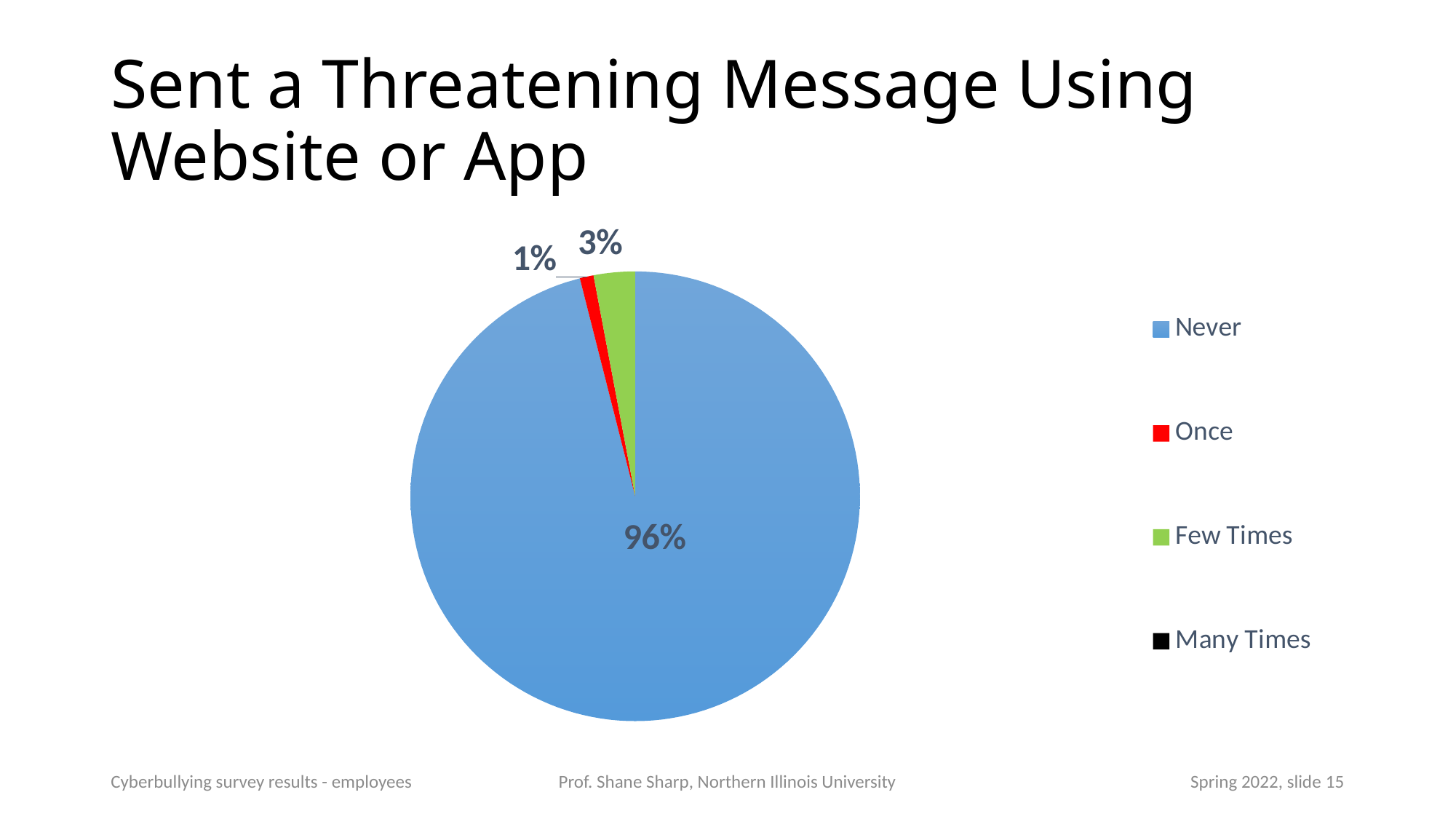
What percentage is shown for the Few Times slice? 3% What is the difference in percentage points between the Never slice and the Few Times slice? 93 How many entries does the legend list? 4 What colour is the Never slice in the pie chart? blue What share of the pie is labelled for the Never slice? 96% What is the title of the slide containing the pie chart? Sent a Threatening Message Using Website or App What kind of chart is shown on the slide? pie chart What percentage is shown for the Once slice? 1% What is the difference in percentage points between the Few Times slice and the Once slice? 2 Which is larger, the Few Times slice or the Once slice? Few Times Is the value for Never greater or less than 50%? greater Which category has the largest slice of the pie? Never